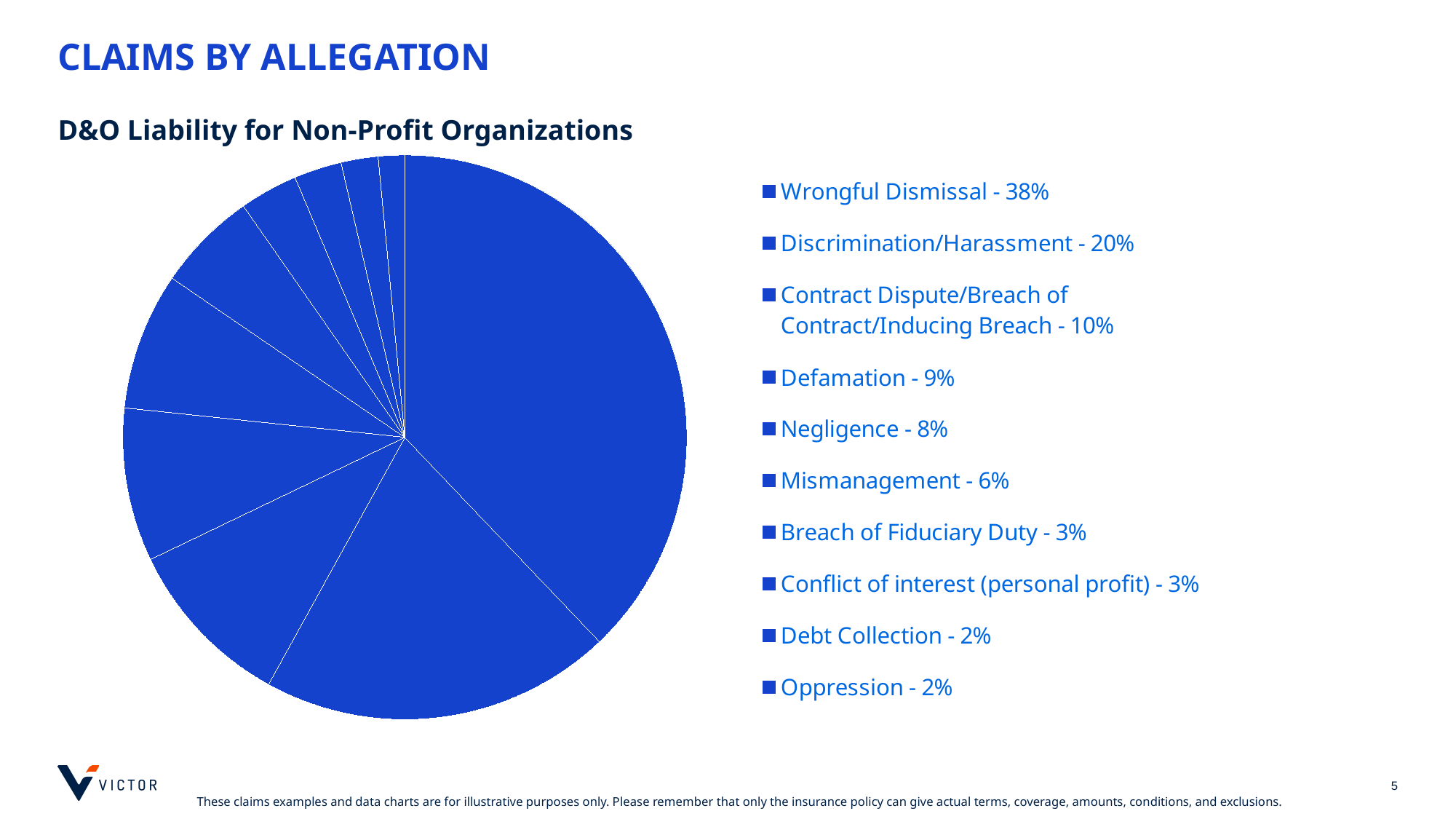
What share of claims is attributed to Wrongful Dismissal? 38% What is the difference in percentage points between the Negligence share and the Mismanagement share? 2 percentage points How many percentage points larger is the Wrongful Dismissal share than the Discrimination/Harassment share? 18 percentage points What kind of chart is shown on the slide? Pie chart What is the subtitle shown above the pie chart? D&O Liability for Non-Profit Organizations What share of claims is for Contract Dispute/Breach of Contract/Inducing Breach? 10% Which allegation category accounts for the largest share of claims? Wrongful Dismissal What percentage of claims is attributed to Mismanagement? 6% What percentage of claims is for Discrimination/Harassment? 20% How many allegation categories does the pie chart show? 10 Which has a larger share of claims, Defamation or Negligence? Defamation What share of claims is for Breach of Fiduciary Duty? 3%